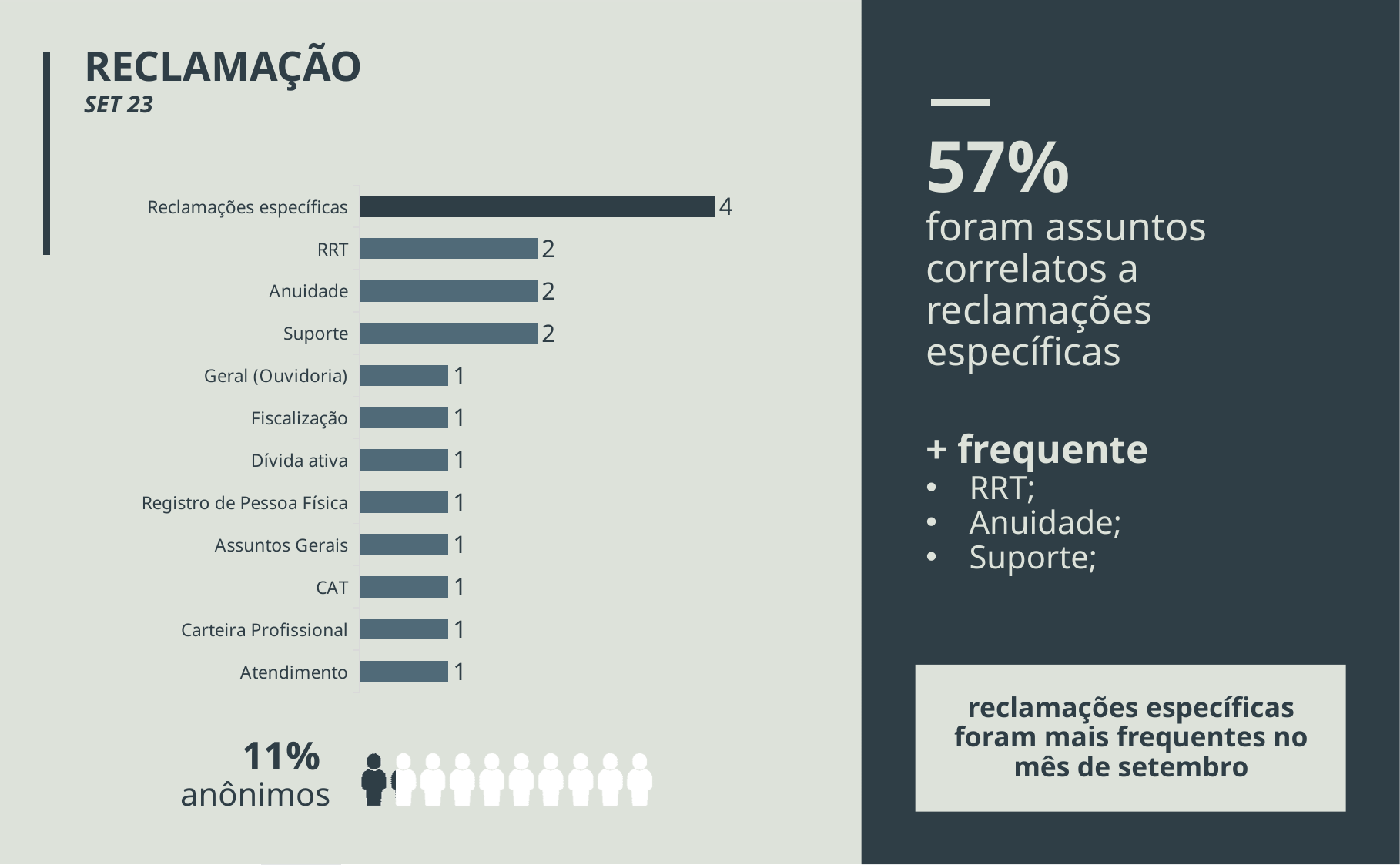
What kind of chart is shown on the slide? Bar chart Which category has the highest value? Reclamações específicas Which bar is shown in a darker colour than the others? Reclamações específicas Which is larger, the value for RRT or the value for CAT? RRT What is the value for Suporte? 2 What is the value for RRT? 2 What is the difference between the values for Suporte and Fiscalização? 1 How many categories are shown in the bar chart? 12 How many categories have a value of 1? 8 What is the difference between the values for Reclamações específicas and Anuidade? 2 What is the value for Reclamações específicas? 4 What is the value for Atendimento? 1